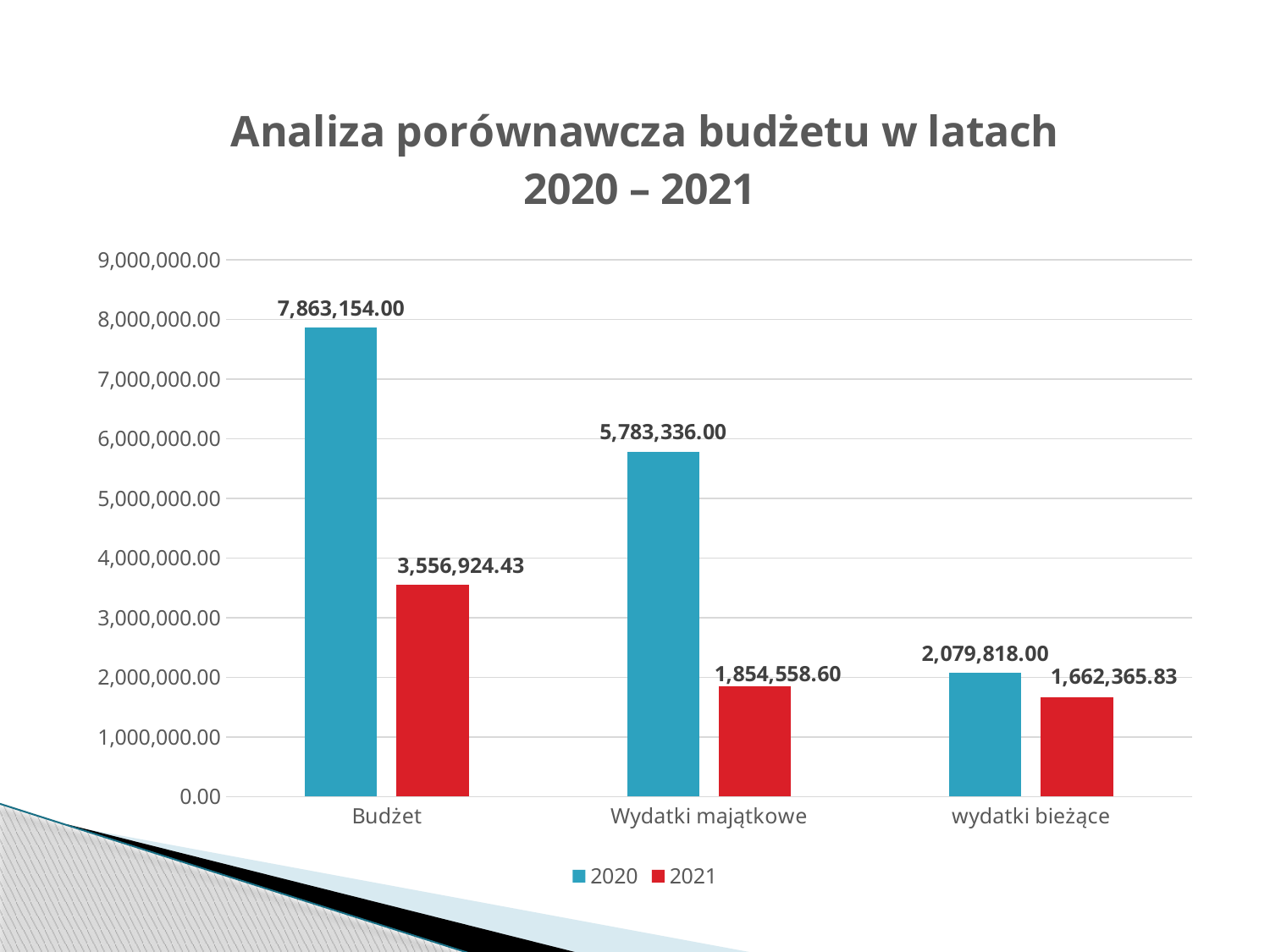
What is the value for wydatki bieżące in the 2020 series? 2,079,818.00 What is the value for Budżet in the 2021 series? 3,556,924.43 How many series does the legend list? 2 What is the value for Wydatki majątkowe in the 2021 series? 1,854,558.60 What is the value for Budżet in the 2020 series? 7,863,154.00 Which category has the highest value in the 2020 series? Budżet How many categories are shown on the x axis? 3 Which category has the lowest value in the 2021 series? wydatki bieżące What is the difference between the 2020 and 2021 values for wydatki bieżące? 417,452.17 What is the difference between the 2020 and 2021 values for Budżet? 4,306,229.57 What type of chart is shown on the slide? Bar chart Which is larger: the 2021 value for Budżet or the 2020 value for wydatki bieżące? The 2021 value for Budżet